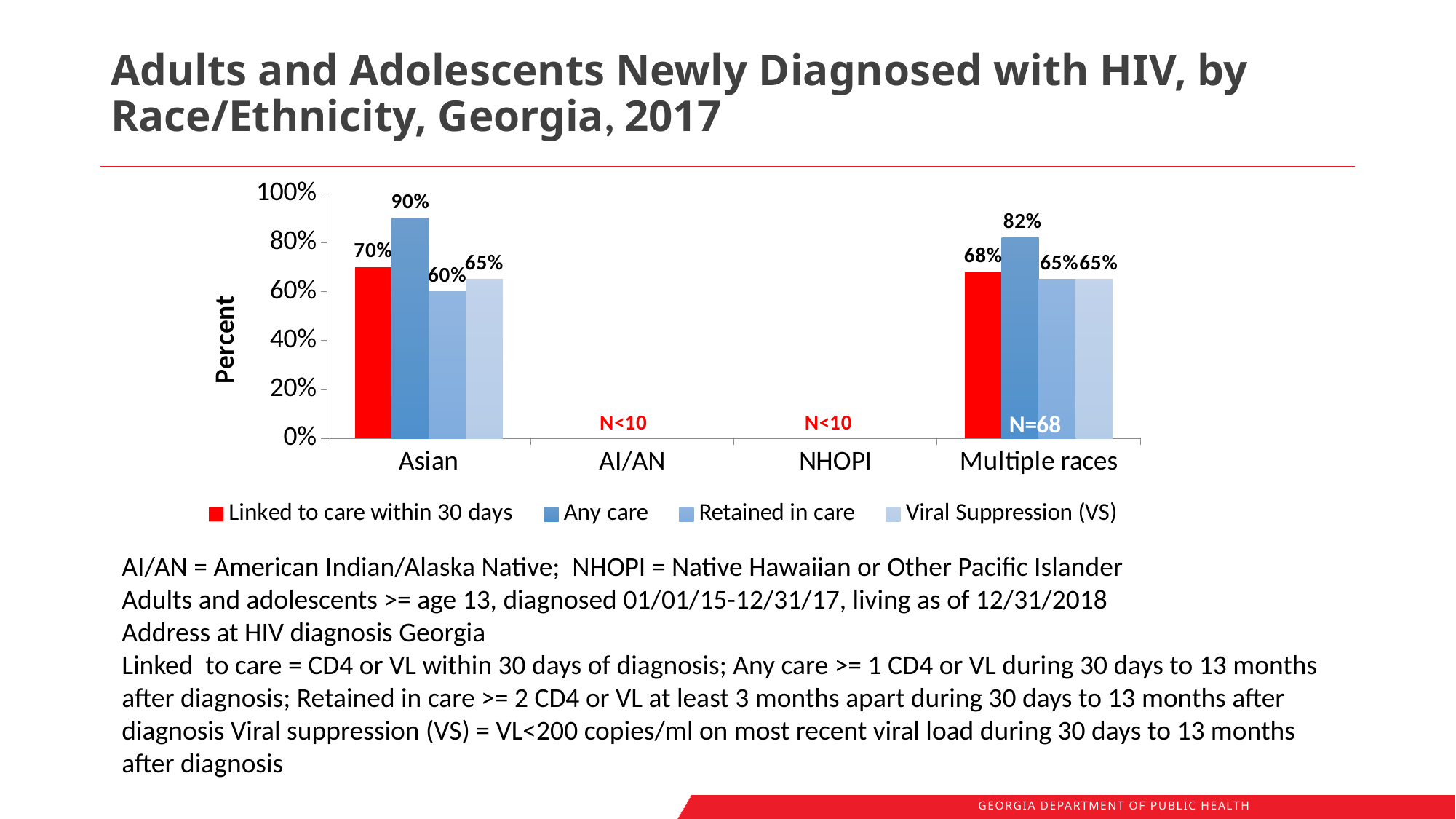
How many series does the legend list? 4 What is the value for Viral Suppression (VS) in the Multiple races category? 65% Which is larger: Linked to care within 30 days for Asian or for Multiple races? Asian What kind of chart is shown on the slide? Bar chart What is the value for Any care in the Asian category? 90% What label is shown for the AI/AN and NHOPI categories instead of bars? N<10 What is the value for Retained in care in the Asian category? 60% What is the difference between Any care for Asian and Any care for Multiple races? 8% Which series has the highest value in the Asian category? Any care Which series has the lowest value in the Asian category? Retained in care What is the value for Linked to care within 30 days in the Multiple races category? 68% What is the difference between Any care and Linked to care within 30 days in the Asian category? 20%